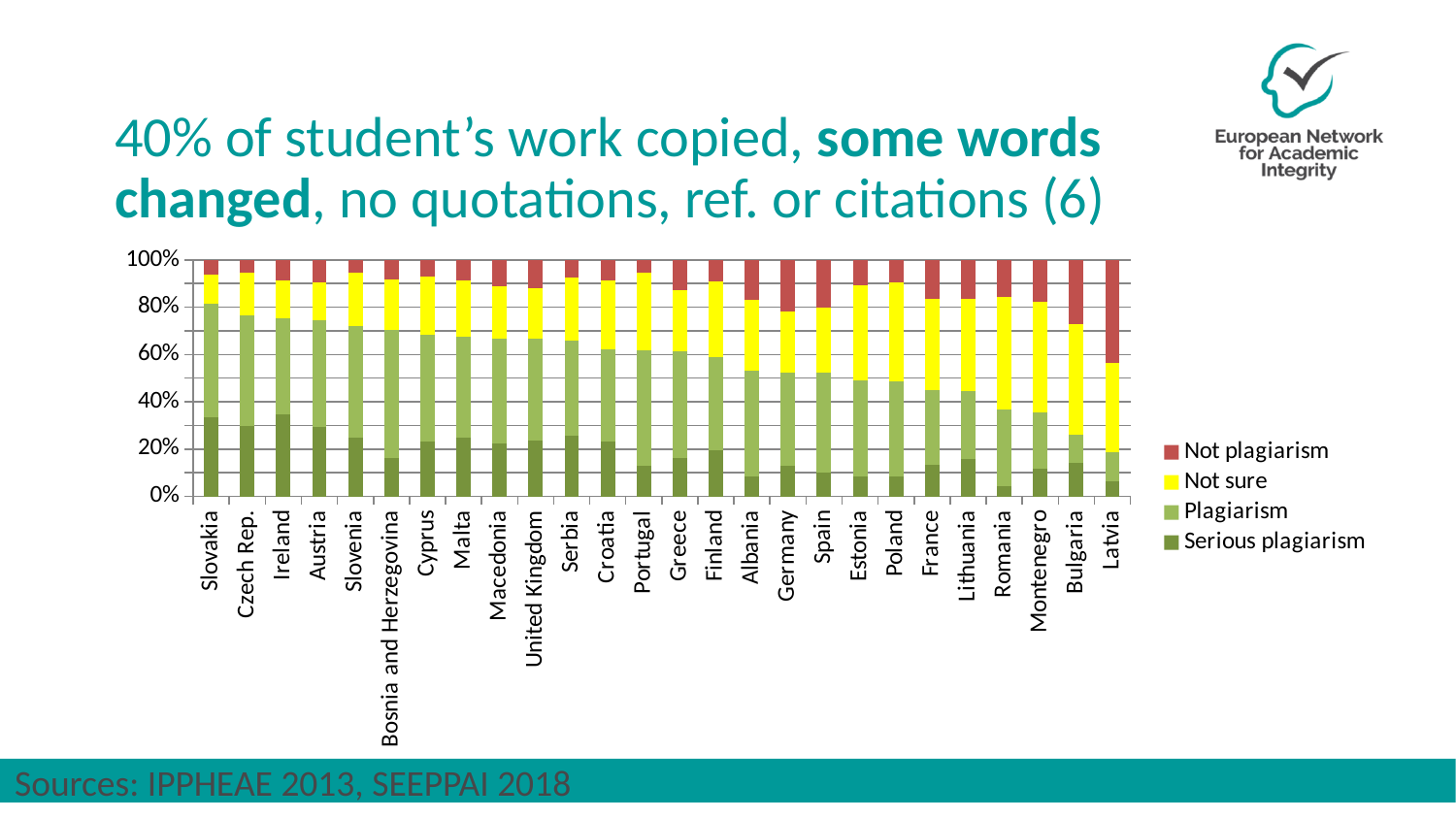
How many series does the chart's legend list? 4 Which country is listed first on the x axis of the chart? Slovakia Which country has the largest 'Not plagiarism' share in the chart? Latvia Is the 'Serious plagiarism' value for Czech Rep. greater or less than 20%? greater Is the 'Serious plagiarism' value for Slovakia greater or less than 20%? greater Which has the larger 'Serious plagiarism' share, Slovakia or Latvia? Slovakia Which colour represents the 'Not sure' series in the chart? Yellow Which country has the largest combined share of 'Serious plagiarism' and 'Plagiarism' in the chart? Slovakia Is the 'Serious plagiarism' value for Romania greater or less than 20%? less Does the combined share of 'Serious plagiarism' and 'Plagiarism' generally rise or fall moving from left to right along the x axis? fall How many countries are shown along the x axis of the chart? 26 What kind of chart is shown on the slide? Stacked bar chart